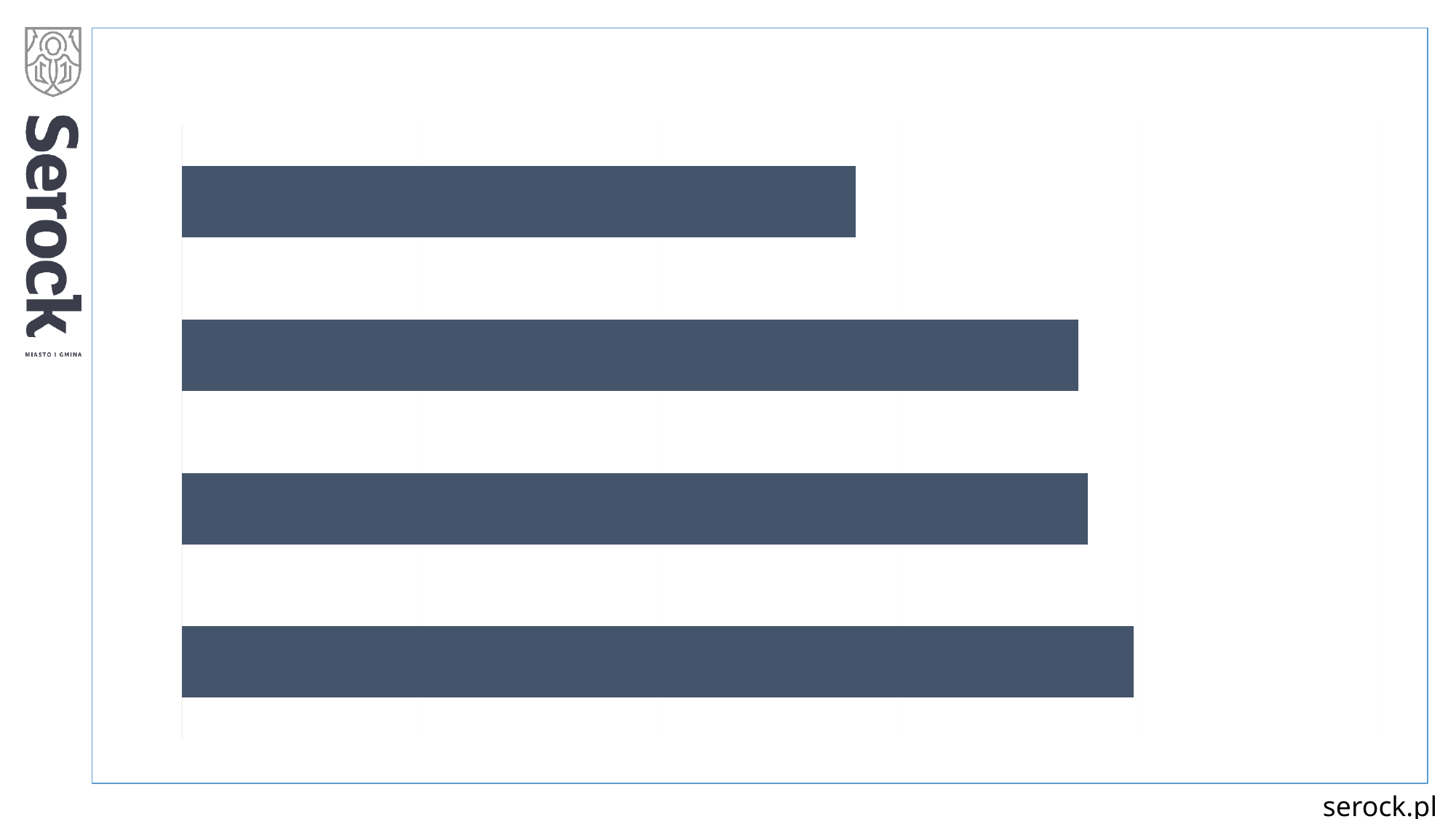
Are the bars in the chart horizontal or vertical? horizontal What kind of chart is shown on the slide? bar chart Does the chart display a title? No Which bar is the longest in the chart? the bottom bar How many bars does the chart show? 4 Is the second bar from the top longer or shorter than the third bar from the top? shorter Do the bars get longer or shorter going from the top of the chart to the bottom? longer Is the top bar longer or shorter than the bottom bar? shorter Which bar is the shortest in the chart? the top bar